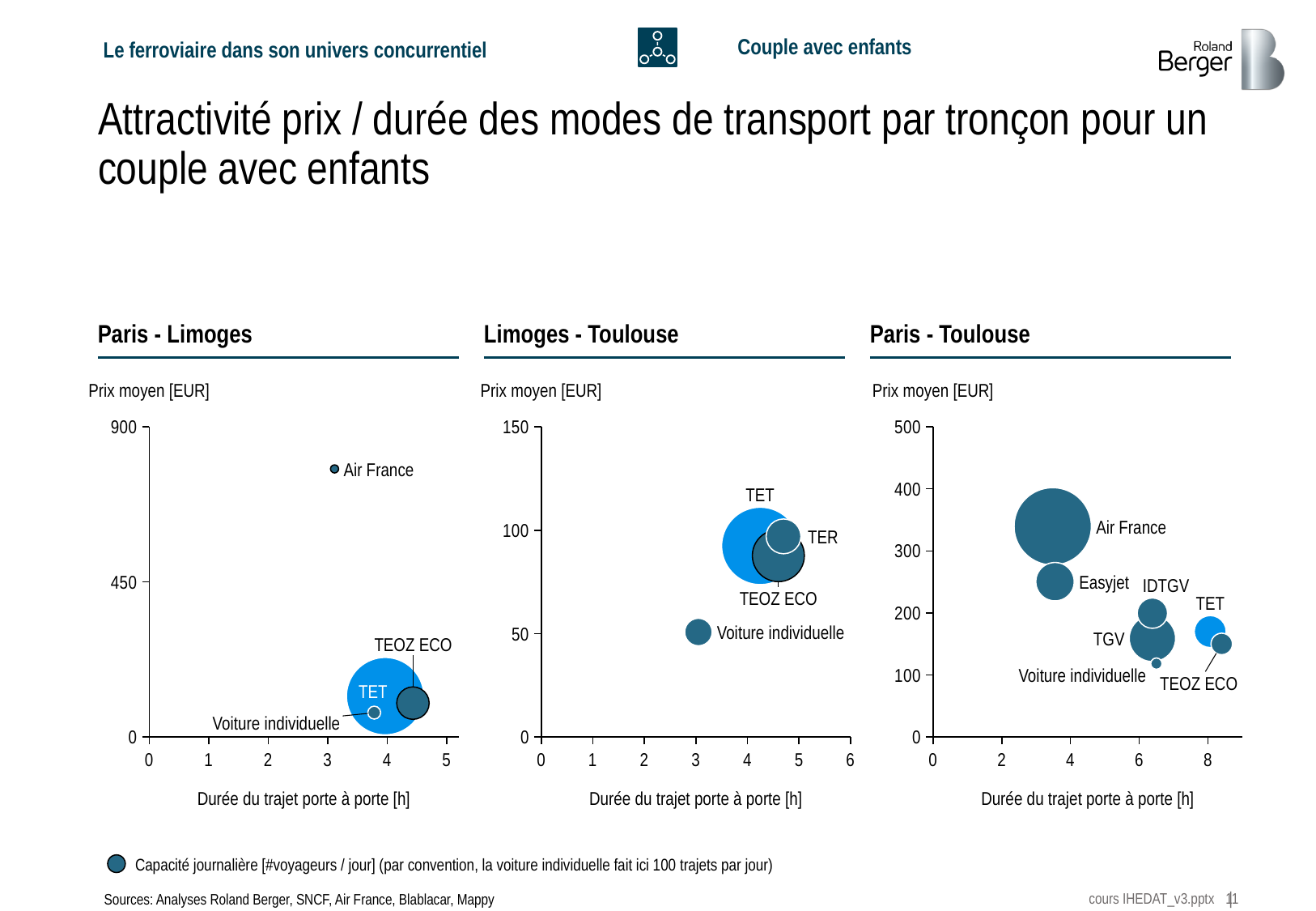
What kind of chart is used on this slide for the three route sections? Bubble chart In the Paris - Toulouse chart, which has the higher average price, Air France or Easyjet? Air France In the Paris - Toulouse chart, which transport mode has the highest average price? Air France According to the legend, what does the size of the bubbles represent? Capacité journalière [#voyageurs / jour] In the Limoges - Toulouse chart, is the door-to-door journey time for Voiture individuelle greater or less than 4 hours? less How many transport modes are plotted in the Paris - Toulouse chart? 7 In the Limoges - Toulouse chart, which transport mode has the lowest average price? Voiture individuelle In the Paris - Limoges chart, which transport mode has the highest average price? Air France How many transport modes are plotted in the Paris - Limoges chart? 4 In the Paris - Limoges chart, is the average price for Air France greater or less than 450 EUR? greater In the Paris - Toulouse chart, is the average price for Air France greater or less than 300 EUR? greater